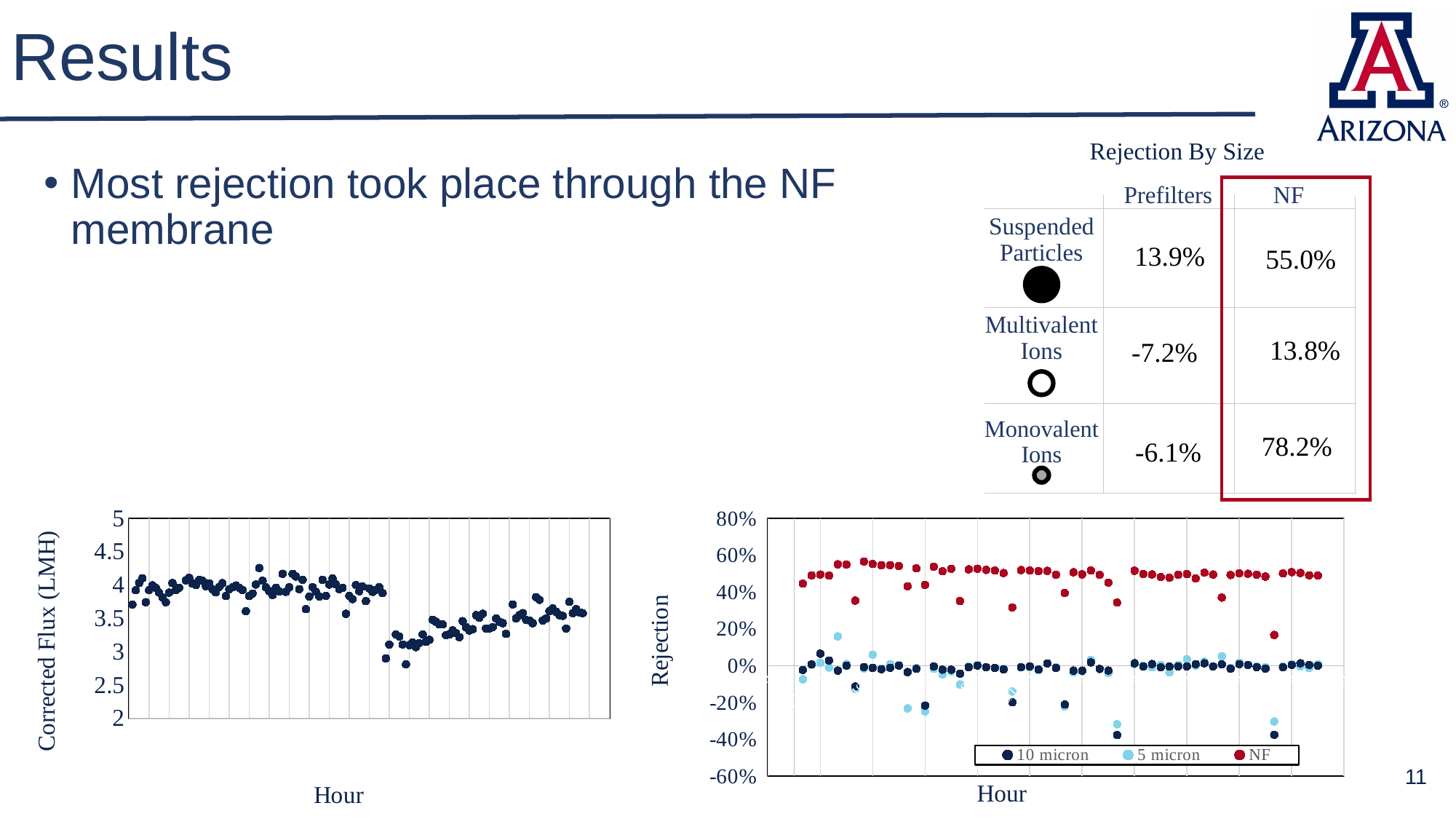
In the left chart (Corrected Flux vs Hour), do the plotted values generally rise or fall along the x axis? fall In the right chart (Rejection vs Hour), how many series does the legend list? 3 In the right chart (Rejection vs Hour), what colour are the NF series points? red In the right chart (Rejection vs Hour), what is the lowest value shown on the y axis? -60% What kind of chart is the left chart with the y axis labelled Corrected Flux (LMH)? scatter chart In the right chart (Rejection vs Hour), are the NF series values larger or smaller than the 10 micron series values? larger In the right chart (Rejection vs Hour), what are the series names listed in the legend? 10 micron, 5 micron, NF What kind of chart is the right chart with the y axis labelled Rejection? scatter chart In the right chart (Rejection vs Hour), which series has the highest rejection values overall: 10 micron, 5 micron or NF? NF In the left chart, what is the label on the y axis? Corrected Flux (LMH) In the right chart (Rejection vs Hour), are most of the NF points greater or less than 40%? greater In the left chart (Corrected Flux vs Hour), what is the highest value shown on the y axis? 5